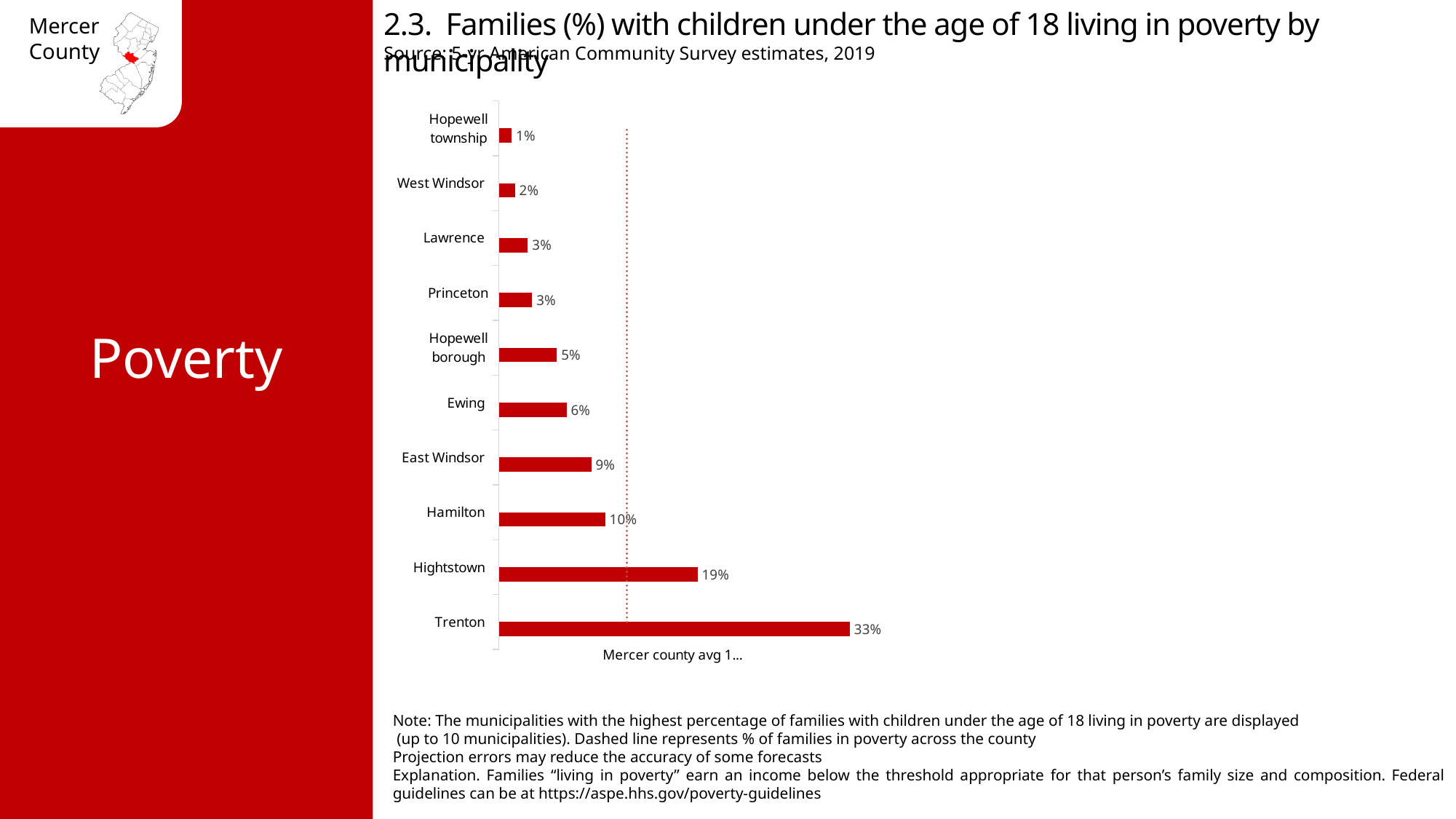
Which municipality has the lowest percentage of families with children under 18 living in poverty? Hopewell township How many municipalities are shown in the chart? 10 What is the value shown for Hopewell township? 1% What is the difference in percentage points between East Windsor and Ewing? 3 Which municipality has the highest percentage of families with children under 18 living in poverty? Trenton What does the dashed vertical line in the chart represent? Mercer county average (% of families in poverty across the county) Which has a higher value, Hamilton or East Windsor? Hamilton What percentage of families with children under 18 are living in poverty in Trenton? 33% What is the difference in percentage points between Trenton and Hightstown? 14 What is the value shown for Hightstown? 19% What kind of chart is shown on the slide? Bar chart What is the value shown for Hamilton? 10%